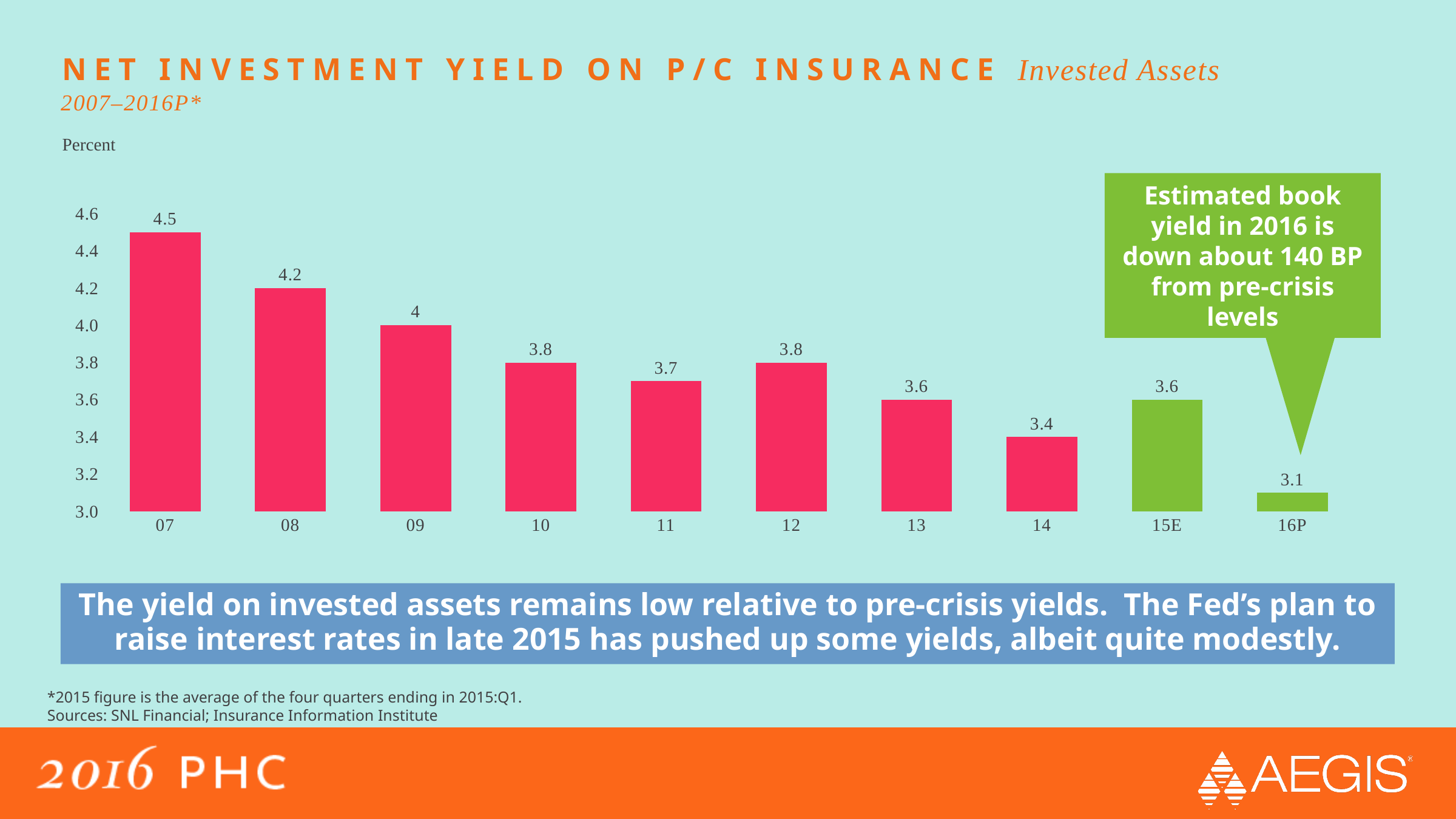
What is the net investment yield for 11? 3.7 Do the yields generally rise or fall from 07 to 14? fall Which is larger, the yield for 14 or the yield for 15E? 15E What is the difference between the yield for 07 and the yield for 16P? 1.4 What is the difference between the yield for 12 and the yield for 13? 0.2 How many years are shown on the x axis? 10 What colour are the bars for 15E and 16P? green What is the net investment yield for 16P? 3.1 Which year has the highest net investment yield? 07 What kind of chart is shown on the slide? bar chart Which year has the lowest net investment yield? 16P What is the net investment yield for 07? 4.5